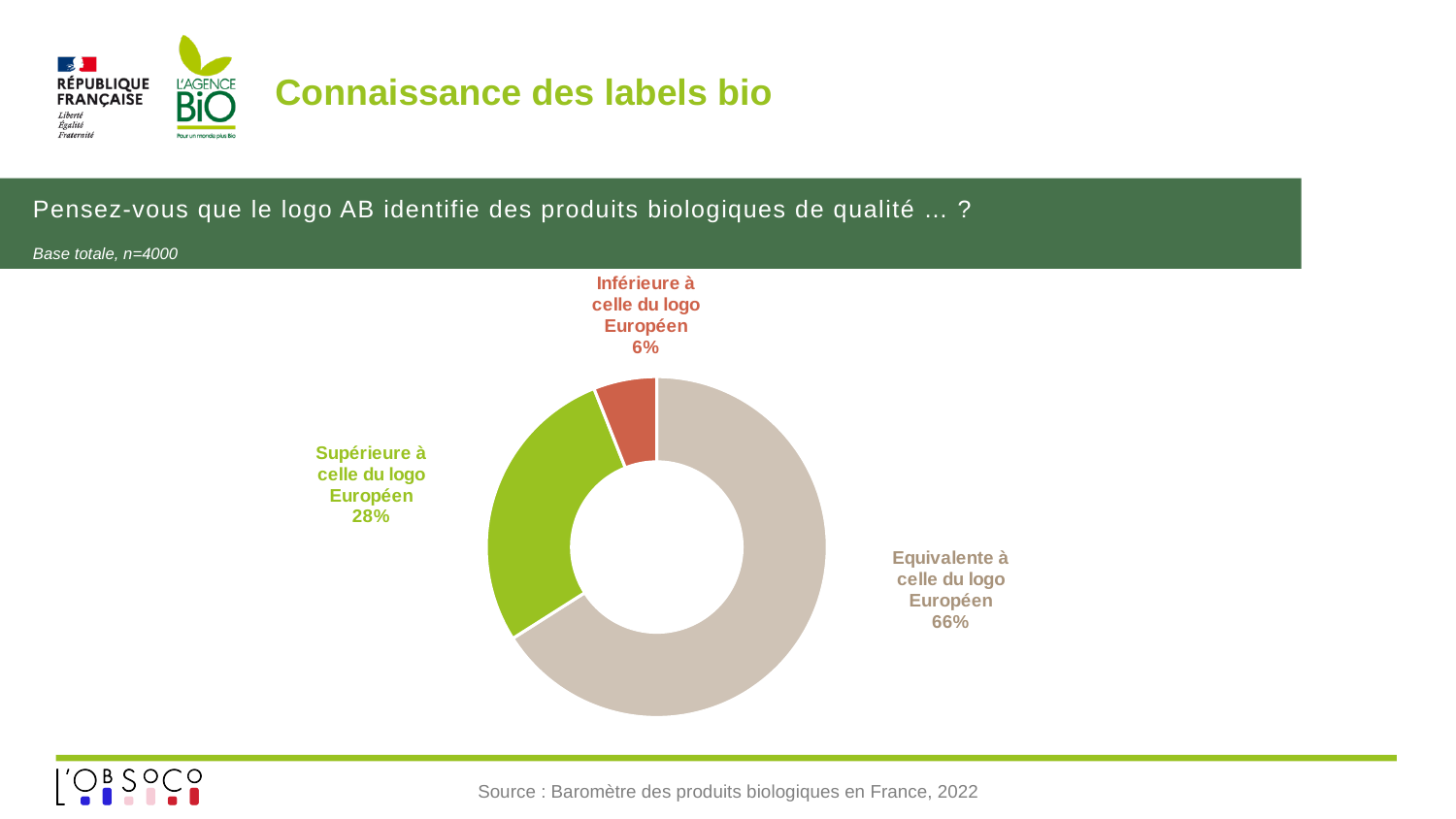
Which response has the smallest share of the chart? Inférieure à celle du logo Européen What kind of chart is shown on the slide? Doughnut (pie) chart What percentage of respondents think the AB logo identifies organic products of quality equivalent to that of the European logo? 66% What percentage of respondents think the AB logo identifies organic products of quality superior to that of the European logo? 28% Which response has the largest share of the chart? Equivalente à celle du logo Européen What percentage of respondents think the AB logo identifies organic products of quality inferior to that of the European logo? 6% Which is larger: the share for 'Supérieure à celle du logo Européen' or the share for 'Inférieure à celle du logo Européen'? Supérieure à celle du logo Européen How many response categories are shown in the chart? 3 What is the difference in percentage points between 'Equivalente à celle du logo Européen' and 'Supérieure à celle du logo Européen'? 38 percentage points What colour is the segment for 'Supérieure à celle du logo Européen'? Green What is the difference in percentage points between 'Supérieure à celle du logo Européen' and 'Inférieure à celle du logo Européen'? 22 percentage points What is the sample size (base) indicated for the chart? n=4000